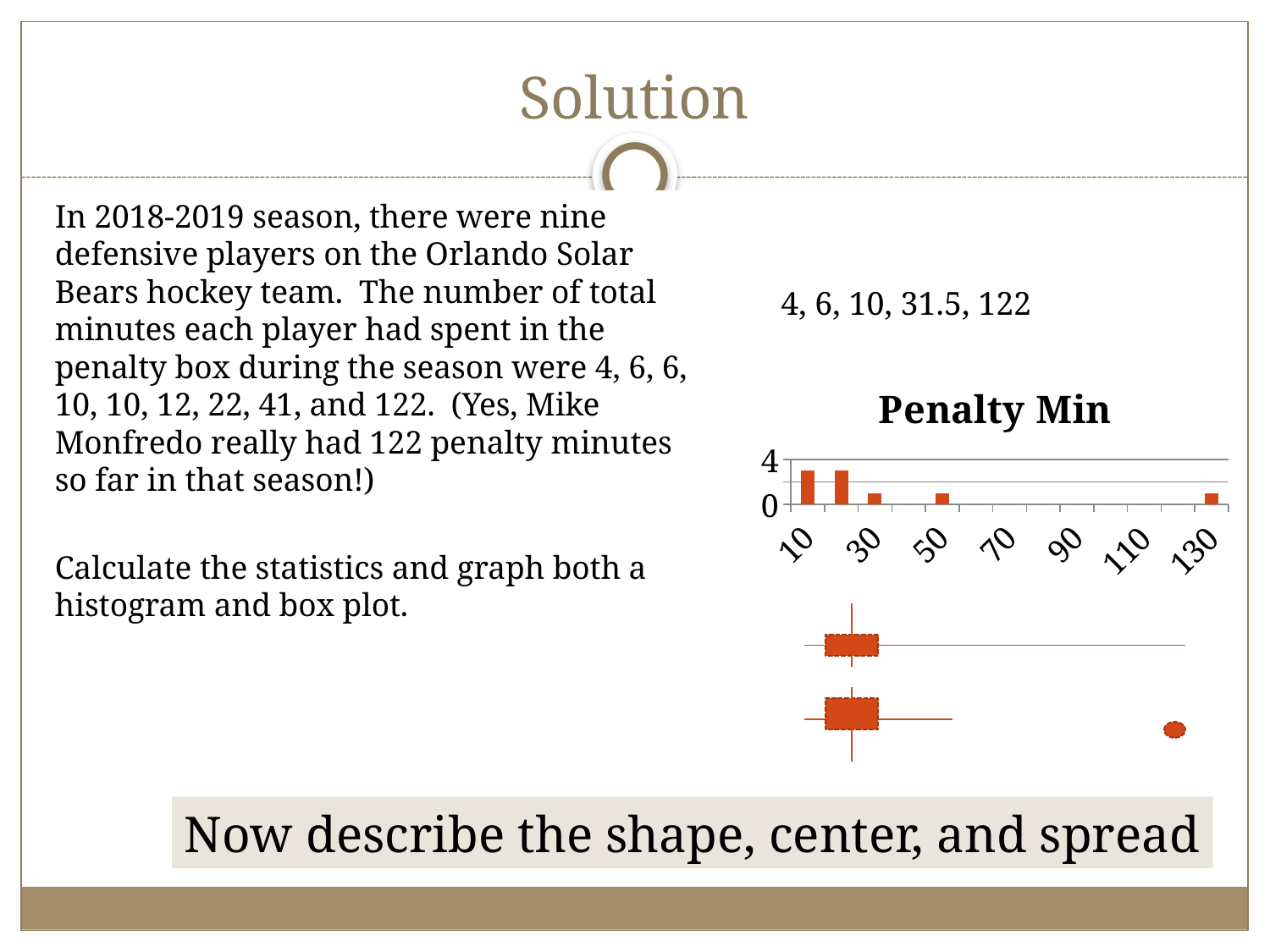
In the Penalty Min chart, which bar is taller, the one at 130 or the one at 10? the one at 10 In the Penalty Min chart, is the value of the bar at 130 greater or less than 4? less What is the first tick label on the x-axis of the Penalty Min chart? 10 In the Penalty Min chart, which bar is taller, the one at 50 or the one at 20? the one at 20 What is the highest value labeled on the y-axis of the Penalty Min chart? 4 In the Penalty Min chart, which bar is taller, the one at 10 or the one at 30? the one at 10 What kind of chart is the Penalty Min chart? bar chart What is the last tick label on the x-axis of the Penalty Min chart? 130 How many bars are plotted in the Penalty Min chart? 5 In the Penalty Min chart, is the value of the bar at 10 greater or less than 4? less What is the title of the chart on the slide? Penalty Min